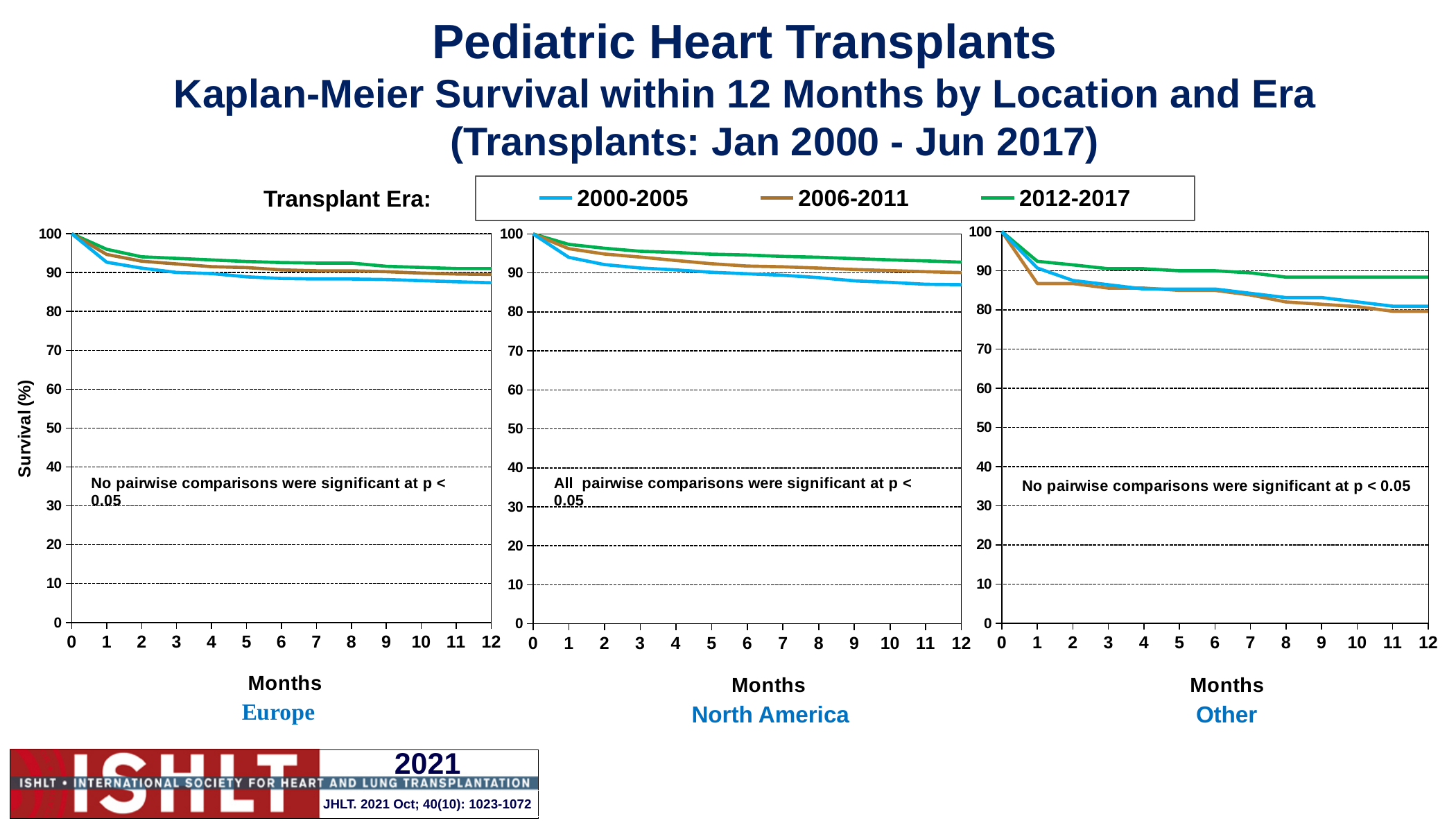
In the Other chart, which era has higher survival at month 12: 2012-2017 or 2006-2011? 2012-2017 What is the label on the y axis of the Europe chart? Survival (%) In the Europe chart, is the survival value for the 2000-2005 era at month 12 greater or less than 90? less How many transplant eras does the legend list? 3 How many charts (location panels) are shown on the slide? 3 In the North America chart, does survival for the 2000-2005 era rise or fall as months increase? fall In the Europe chart, which era has the lowest survival at month 12? 2000-2005 In the North America chart, which era has the highest survival at month 12? 2012-2017 In the Europe chart, what is the survival value for the 2012-2017 era at month 0? 100 In the North America chart, is the survival value for the 2000-2005 era at month 12 greater or less than 90? less What type of chart is used for the Europe panel? line chart